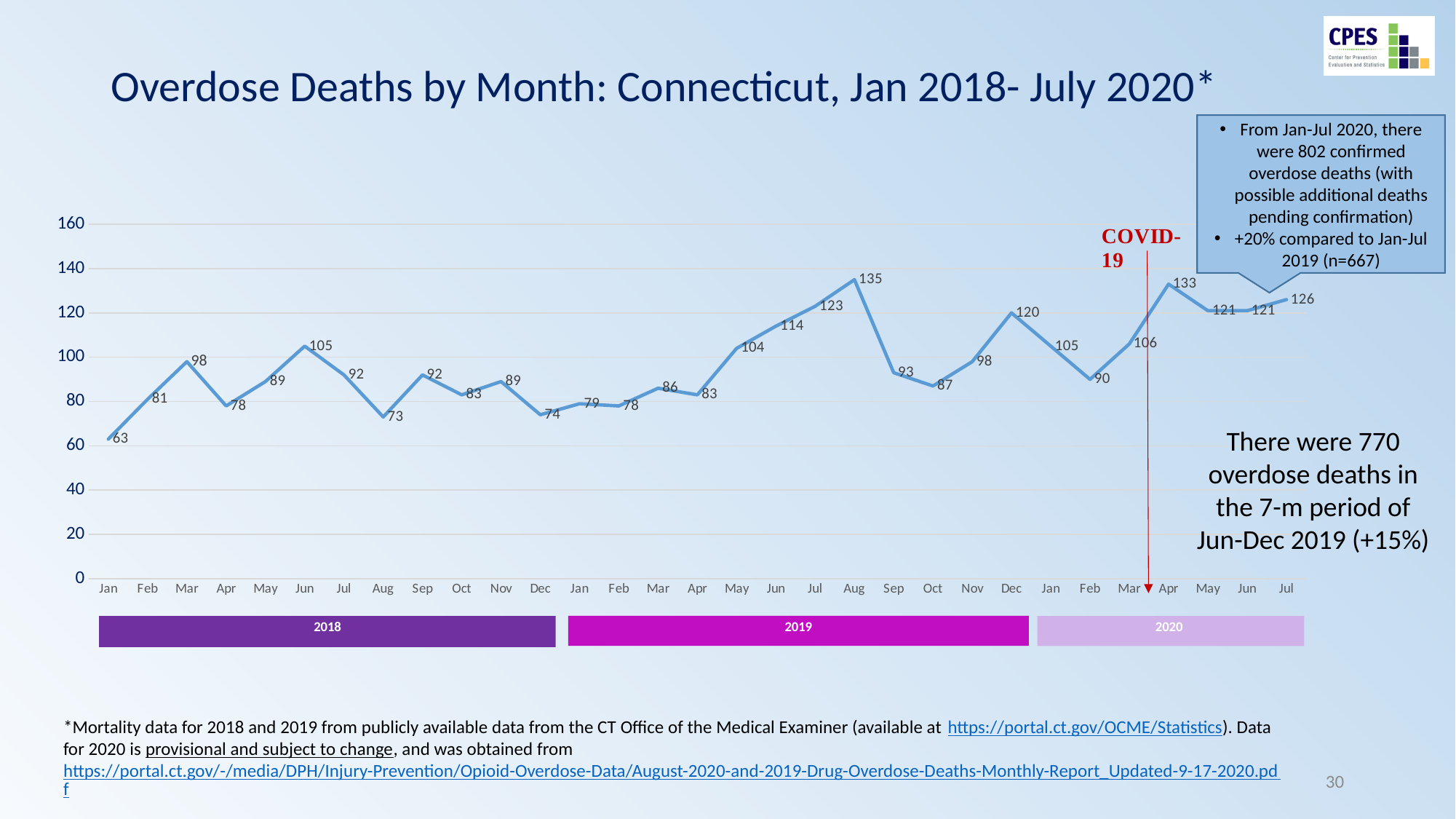
What kind of chart is shown on the slide? line chart Do overdose deaths rise or fall from Jan 2019 to Aug 2019? rise How many monthly data points are plotted on the chart? 31 What is the number of overdose deaths for Aug 2019? 135 Which month has the lowest number of overdose deaths? Jan 2018 What is the number of overdose deaths for Jan 2018? 63 What is the title of the chart? Overdose Deaths by Month: Connecticut, Jan 2018- July 2020* What is the difference in overdose deaths between Aug 2019 and Sep 2019? 42 What is the number of overdose deaths for Apr 2020? 133 What is the number of overdose deaths for Jul 2020? 126 Which month has the highest number of overdose deaths? Aug 2019 Which has more overdose deaths, Jun 2018 or Jun 2019? Jun 2019